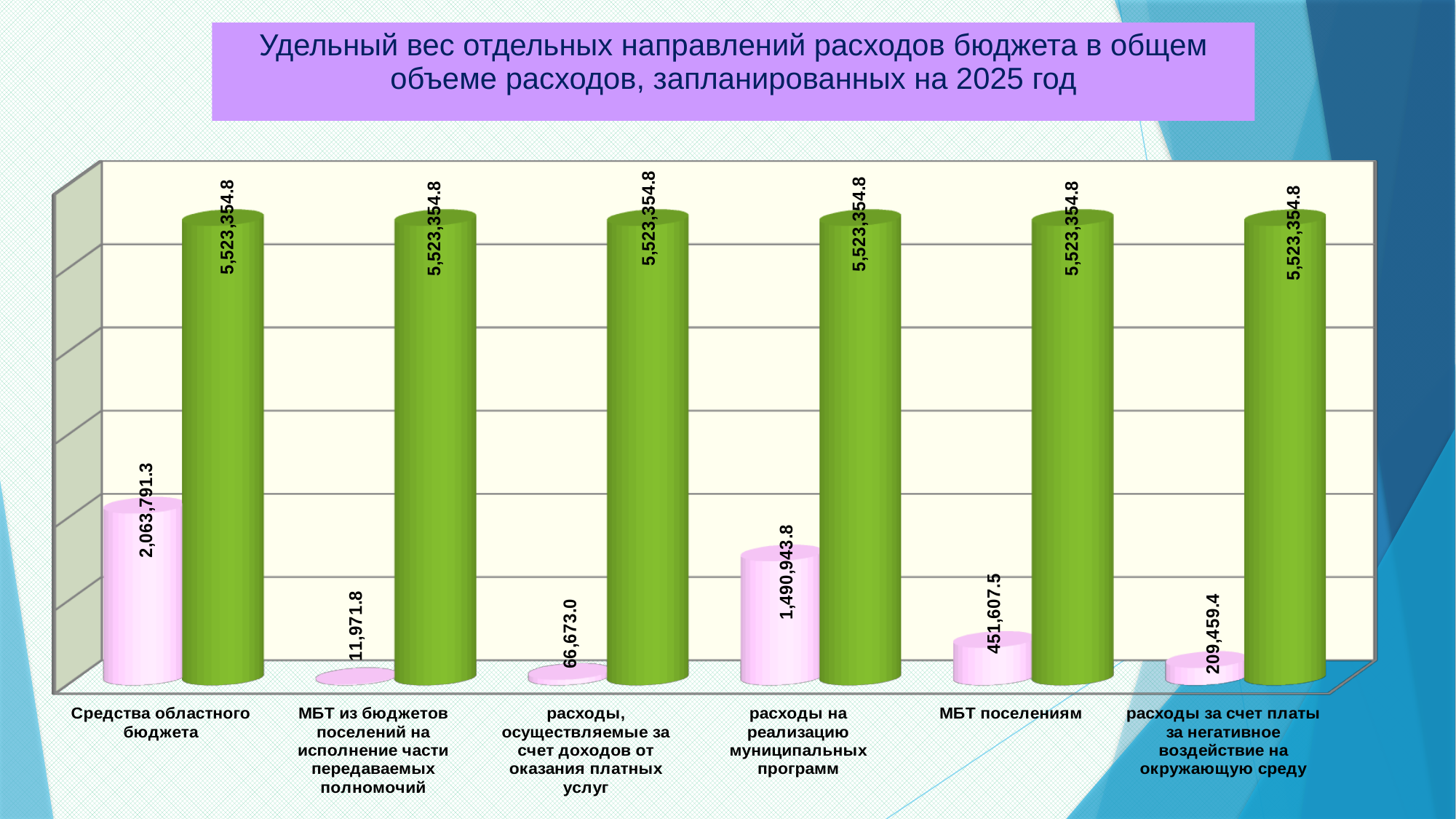
What is the value of the pink bar for "расходы на реализацию муниципальных программ"? 1,490,943.8 What is the value of the pink bar for "МБТ поселениям"? 451,607.5 What is the value of the pink bar for "Средства областного бюджета"? 2,063,791.3 What is the difference between the pink bar for "МБТ поселениям" and the pink bar for "расходы за счет платы за негативное воздействие на окружающую среду"? 242,148.1 Which category has the highest pink bar? Средства областного бюджета What kind of chart is shown on the slide? Bar chart Which category has the lowest pink bar? МБТ из бюджетов поселений на исполнение части передаваемых полномочий What is the difference between the pink bar for "Средства областного бюджета" and the pink bar for "расходы на реализацию муниципальных программ"? 572,847.5 What value is shown on each of the green bars? 5,523,354.8 Which pink bar is larger: "расходы, осуществляемые за счет доходов от оказания платных услуг" or "МБТ из бюджетов поселений на исполнение части передаваемых полномочий"? расходы, осуществляемые за счет доходов от оказания платных услуг What year is mentioned in the chart title? 2025 How many categories are shown on the x axis of the chart? 6